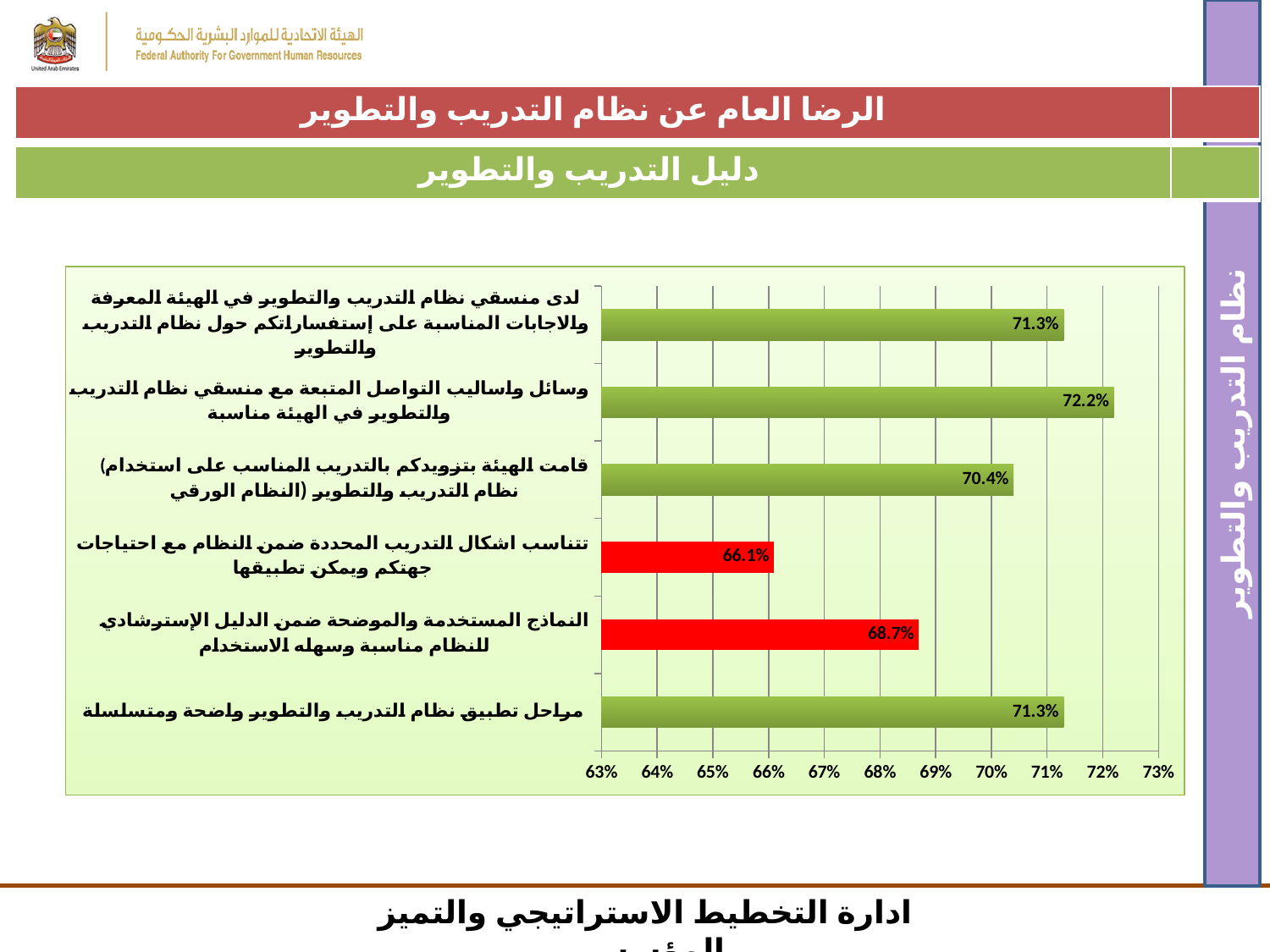
Which is larger: the value for "النماذج المستخدمة والموضحة ضمن الدليل الإسترشادي" or the value for "قامت الهيئة بتزويدكم بالتدريب المناسب"? قامت الهيئة بتزويدكم بالتدريب المناسب What is the value for "النماذج المستخدمة والموضحة ضمن الدليل الإسترشادي للنظام مناسبة وسهلة الاستخدام"? 68.7% What is the value for "وسائل واساليب التواصل المتبعة مع منسقي نظام التدريب والتطوير في الهيئة مناسبة"? 72.2% How many bars are coloured red? 2 Which category has the highest value? وسائل واساليب التواصل المتبعة مع منسقي نظام التدريب والتطوير في الهيئة مناسبة Which category has the lowest value? تتناسب اشكال التدريب المحددة ضمن النظام مع احتياجات جهتكم ويمكن تطبيقها Is the value for "مراحل تطبيق نظام التدريب والتطوير واضحة ومتسلسلة" greater or less than 70%? greater What is the difference between the highest value (72.2%) and the lowest value (66.1%)? 6.1% What is the value for "قامت الهيئة بتزويدكم بالتدريب المناسب على استخدام نظام التدريب والتطوير (النظام الورقي)"? 70.4% What kind of chart is shown on the slide? Bar chart What is the value for "تتناسب اشكال التدريب المحددة ضمن النظام مع احتياجات جهتكم ويمكن تطبيقها"? 66.1% How many categories are shown in the chart? 6